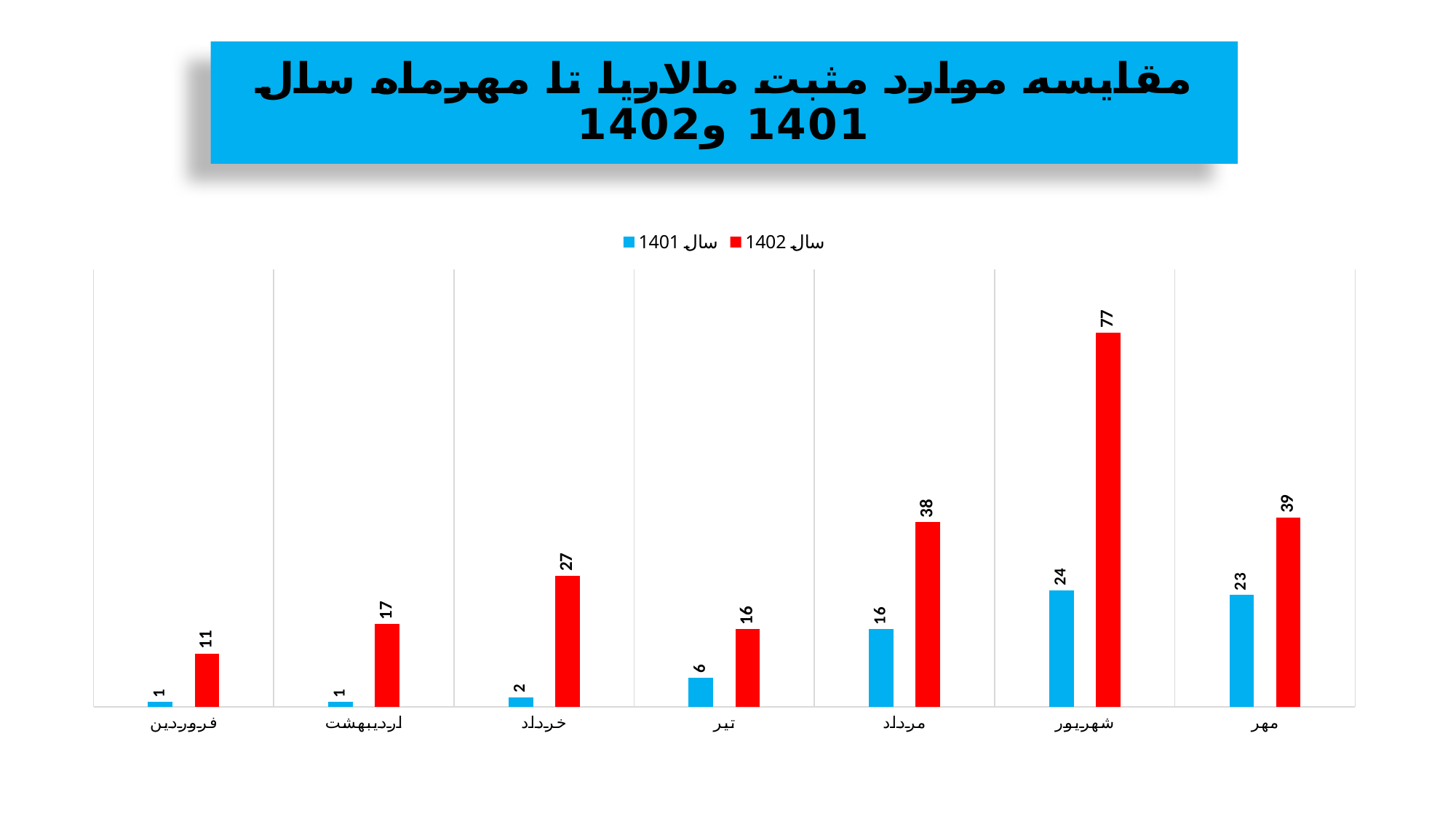
Which is larger in تیر: the value for سال 1401 or سال 1402? سال 1402 Which month has the highest value for سال 1402? شهریور How many months are shown on the x axis? 7 What is the value for سال 1402 in خرداد? 27 What is the difference between the سال 1402 and سال 1401 values in شهریور? 53 Which month has the lowest value for سال 1402? فروردین What is the difference between the سال 1402 values for مهر and مرداد? 1 What kind of chart is shown on the slide? Bar chart How many series does the legend list? 2 What is the value for سال 1401 in مرداد? 16 Which colour represents سال 1402 in the chart? Red What is the value for سال 1402 in شهریور? 77